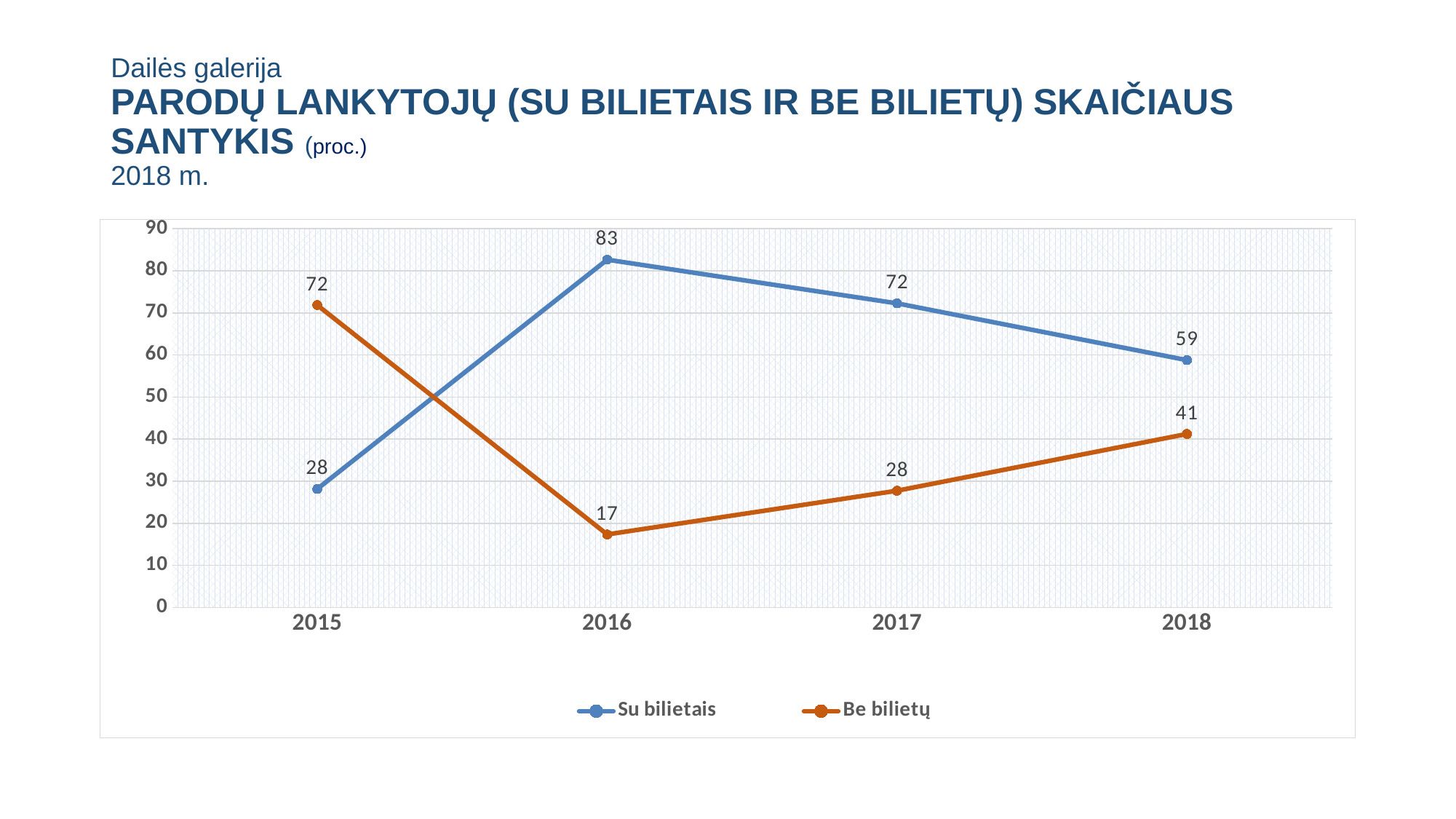
How many series does the legend list? 2 What is the difference between Su bilietais and Be bilietų in 2017? 44 What colour is the line for Be bilietų? Orange What is the value for Be bilietų in 2018? 41 What kind of chart is shown on the slide? Line chart What is the value for Be bilietų in 2015? 72 Does the Su bilietais series rise or fall from 2016 to 2018? Fall In which year is the Su bilietais value highest? 2016 Which series has the larger value in 2015, Su bilietais or Be bilietų? Be bilietų How many years are shown on the x axis? 4 What is the value for Su bilietais in 2016? 83 In which year is the Be bilietų value lowest? 2016